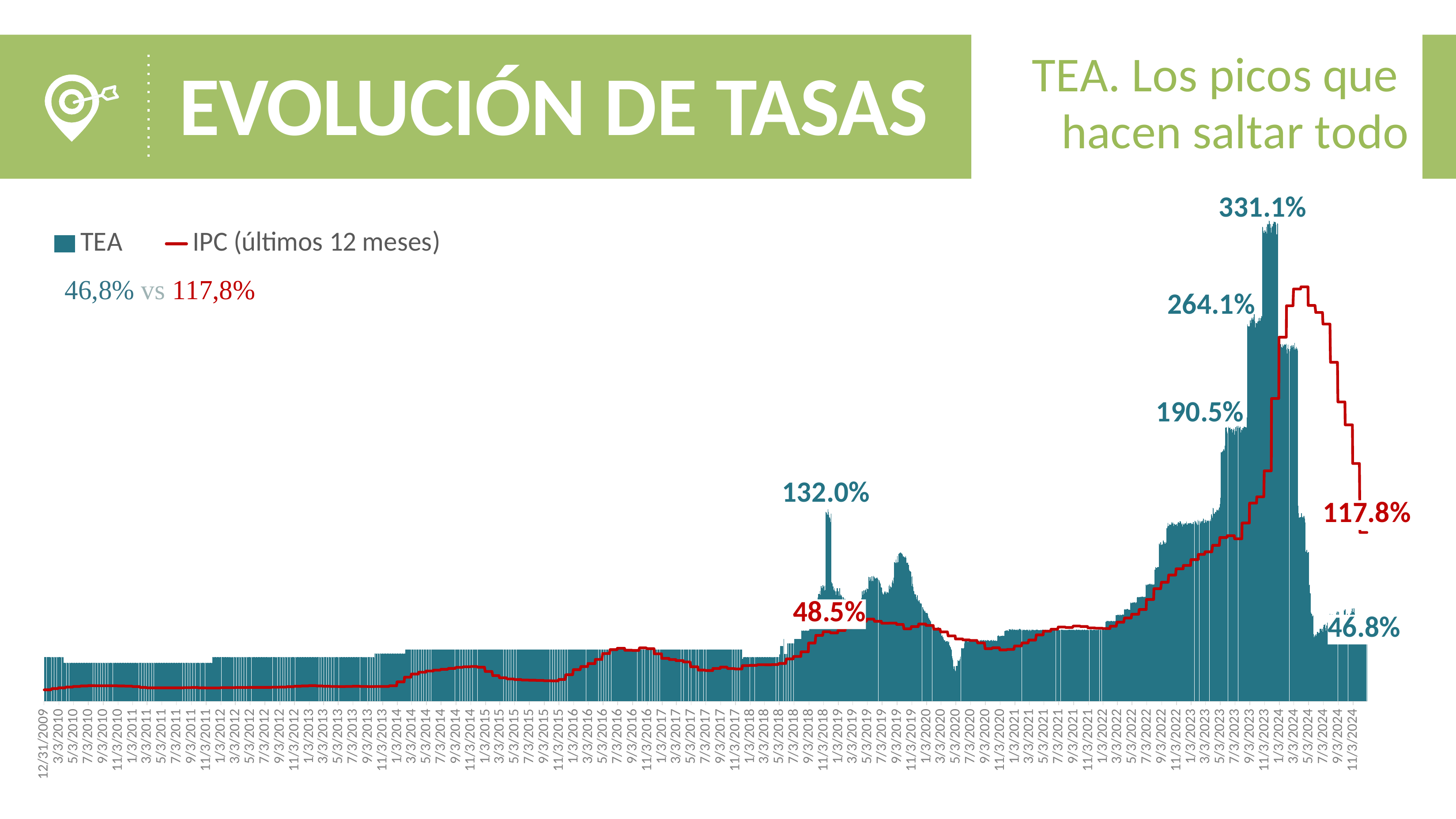
What is the difference between the TEA peaks labelled 331.1% and 264.1%? 67.0% What is the highest TEA value labelled on the chart? 331.1% What colour is the IPC (últimos 12 meses) line? Red What is the last IPC (últimos 12 meses) value labelled at the right end of the chart? 117.8% What is the last TEA value labelled at the right end of the chart? 46.8% How many series does the legend list? 2 What is the difference between the final IPC value (117.8%) and the final TEA value (46.8%)? 71.0% Does the IPC line rise or fall over the final months shown in 2024? Fall How many TEA peak values are labelled on the chart (excluding the final 46.8%)? 4 What kind of chart is shown on the slide? Bar chart with a line overlay Which is larger at the right end of the chart, the IPC value or the TEA value? IPC What IPC value is labelled in red near early 2019? 48.5%